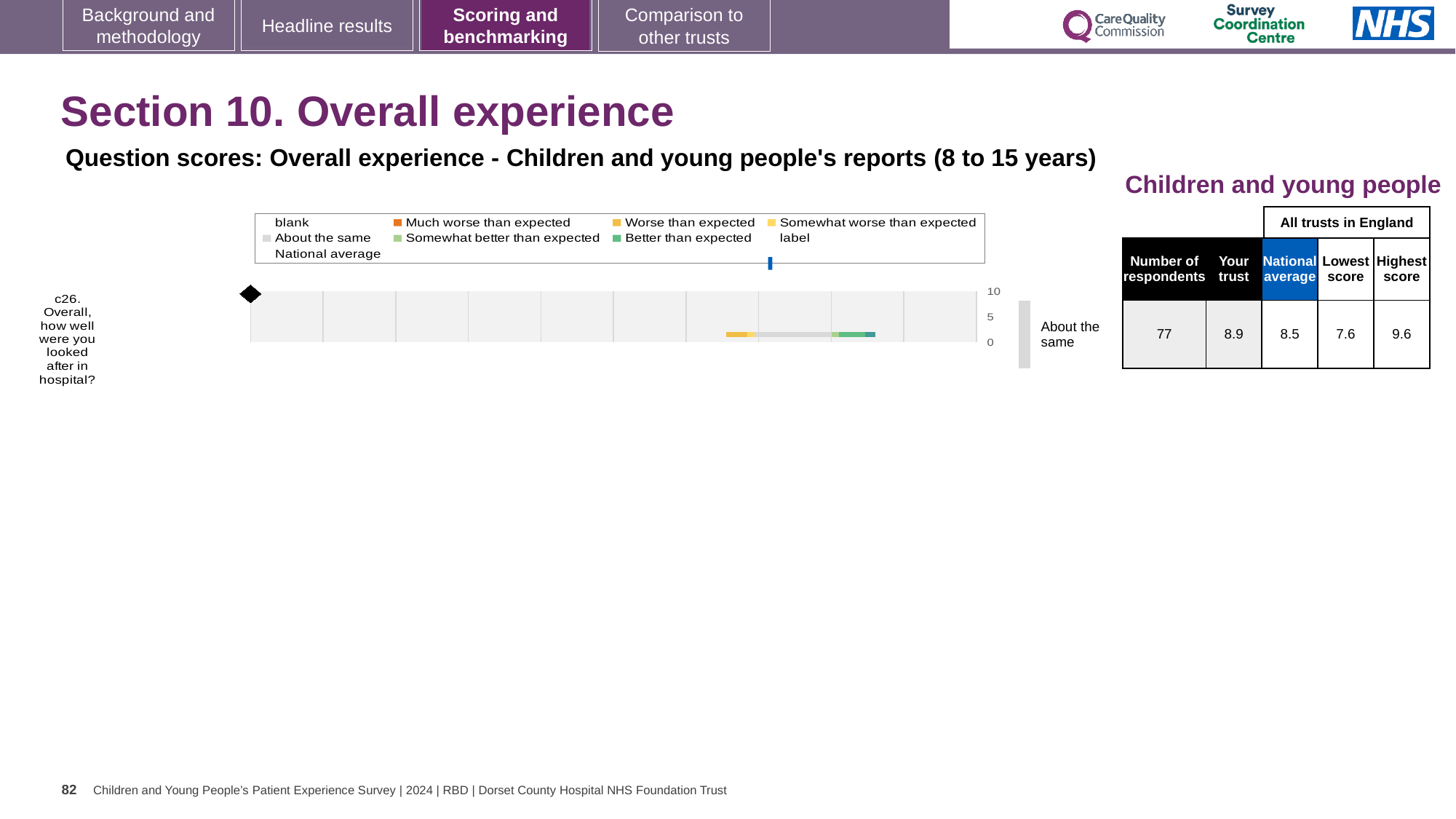
What is the lowest score among all trusts in England for c26? 7.6 What kind of chart is used to show the c26 question score? Bar chart What is the maximum value shown on the chart's score axis? 10 How many respondents answered question c26? 77 What is the highest score among all trusts in England for c26? 9.6 Which question is plotted in the chart? c26. Overall, how well were you looked after in hospital? What is the 'Your trust' score for c26 shown in the table beside the chart? 8.9 What benchmark category label is shown to the right of the bar for c26? About the same For c26, what is the difference between the 'Your trust' score and the national average? 0.4 For c26, which is higher: the 'Your trust' score or the national average? Your trust How many survey questions are plotted in the chart? 1 What is the national average score for c26 shown in the table beside the chart? 8.5